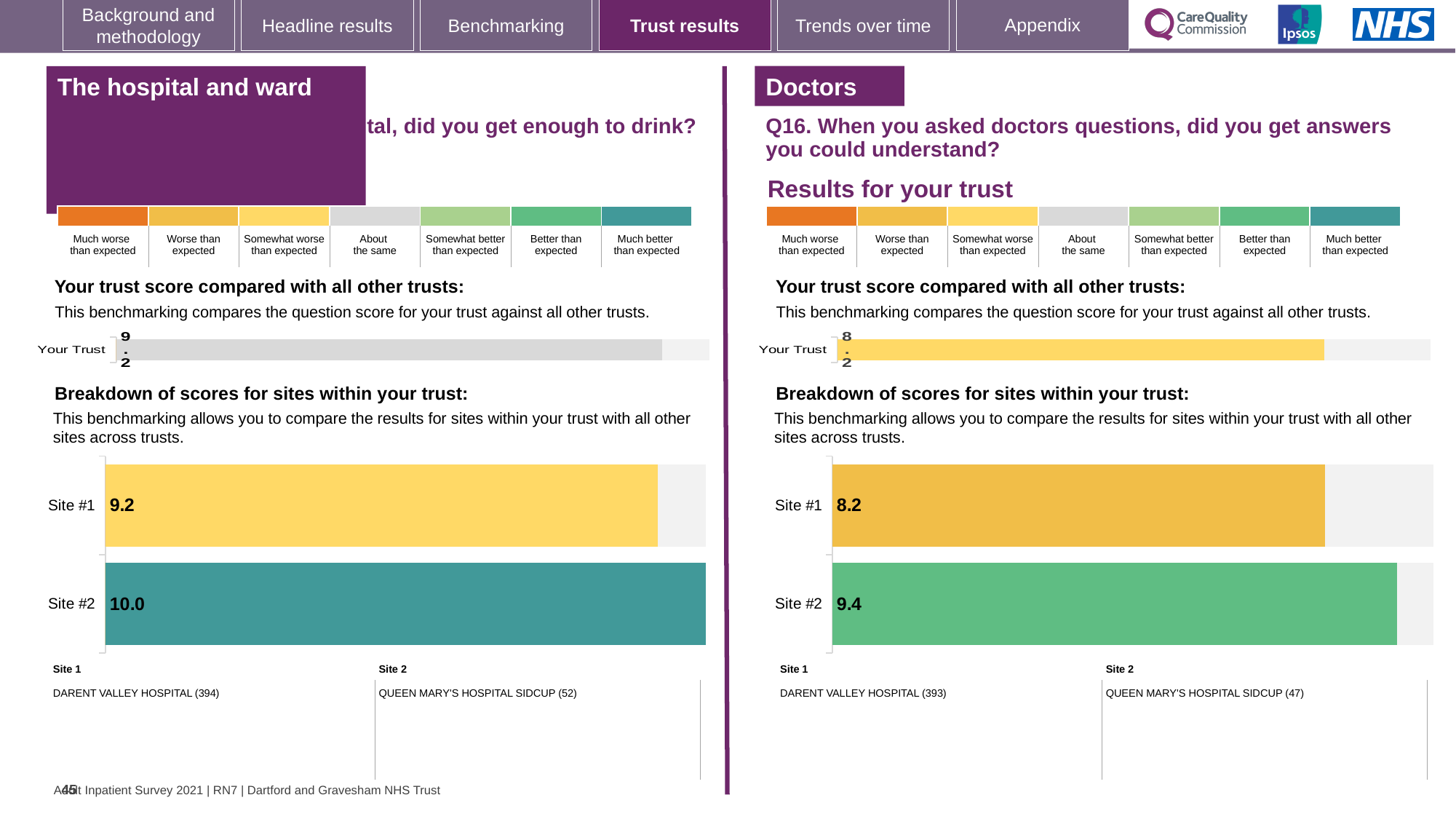
In the site breakdown chart on the left-hand side of the slide, what is the score for Site #1? 9.2 In the 'Your trust score compared with all other trusts' chart on the left-hand side of the slide, what is the score shown for Your Trust? 9.2 What type of chart is used for the breakdown of scores for sites within your trust on the right-hand side of the slide? Bar chart In the site breakdown chart on the left-hand side of the slide, which site has the higher score? Site #2 In the 'Your trust score compared with all other trusts' chart under Q16 (Doctors), what is the score shown for Your Trust? 8.2 In the site breakdown chart under Q16 (Doctors) on the right-hand side, what is the score for Site #1? 8.2 In the site breakdown chart under Q16 (Doctors), which site has the lower score? Site #1 How many sites are shown in the site breakdown chart under Q16 (Doctors)? 2 In the site breakdown chart under Q16 (Doctors) on the right-hand side, what is the score for Site #2? 9.4 In the site breakdown chart on the left-hand side of the slide, what is the score for Site #2? 10.0 In the site breakdown chart on the left-hand side of the slide, what is the difference between the Site #2 and Site #1 scores? 0.8 In the site breakdown chart under Q16 (Doctors), what is the difference between the Site #2 and Site #1 scores? 1.2